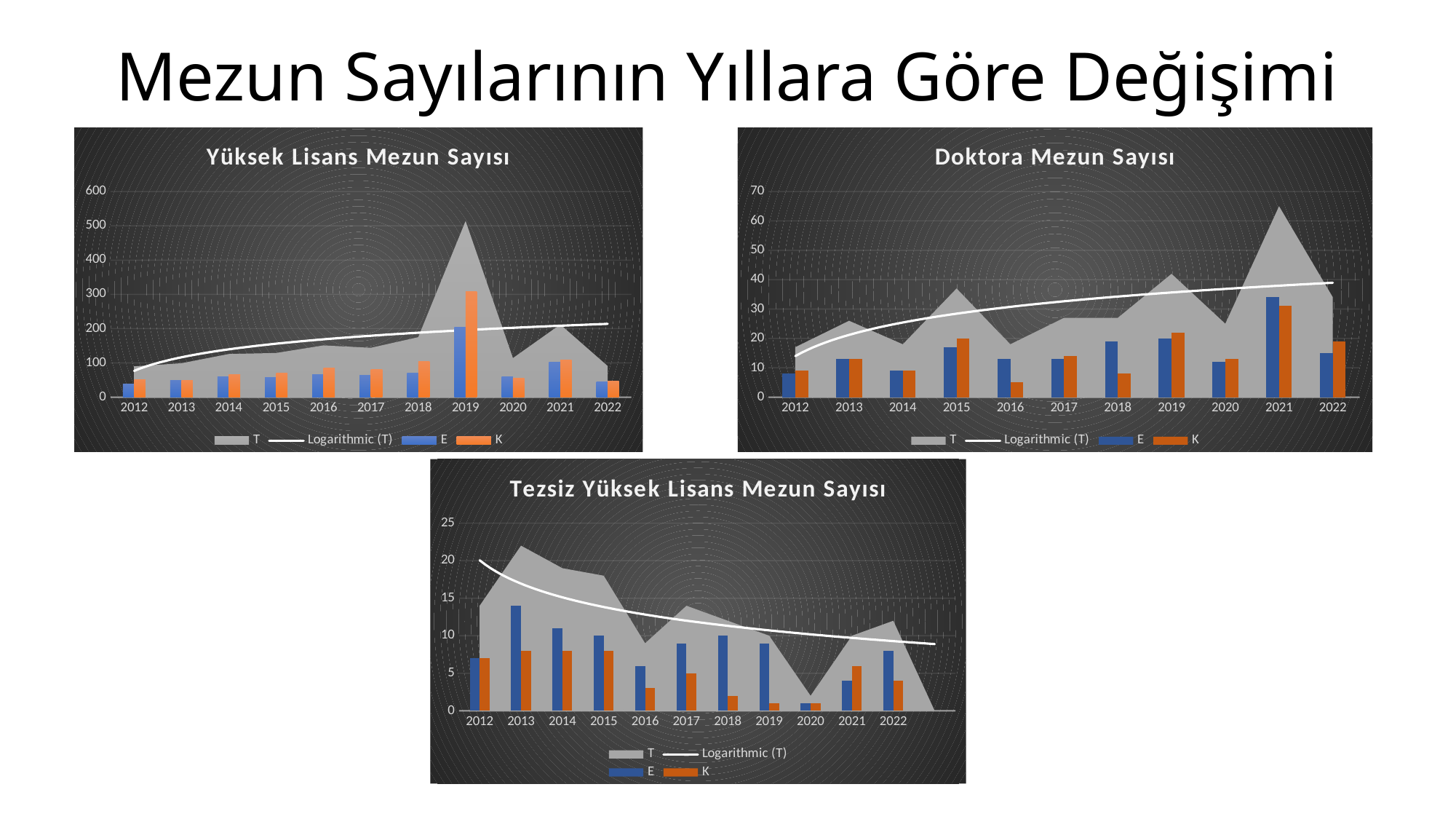
In the Doktora Mezun Sayısı chart, is the value for E in 2021 greater or less than 30? greater In the Doktora Mezun Sayısı chart, how many entries does the legend list? 4 In the Yüksek Lisans Mezun Sayısı chart, how many years are shown on the x axis? 11 In the Tezsiz Yüksek Lisans Mezun Sayısı chart, does the Logarithmic (T) trend line rise or fall from 2012 to 2022? fall In the Doktora Mezun Sayısı chart, in which year is the K series lowest? 2016 In the Tezsiz Yüksek Lisans Mezun Sayısı chart, what kind of chart is used to plot the E and K series? bar chart In the Yüksek Lisans Mezun Sayısı chart, which is larger in 2019, E or K? K In the Tezsiz Yüksek Lisans Mezun Sayısı chart, in which year is the E series highest? 2013 In the Tezsiz Yüksek Lisans Mezun Sayısı chart, which is larger in 2013, E or K? E In the Doktora Mezun Sayısı chart, in which year does the T series reach its peak? 2021 In the Yüksek Lisans Mezun Sayısı chart, in which year is the K series highest? 2019 In the Yüksek Lisans Mezun Sayısı chart, is the value for K in 2019 greater or less than 200? greater